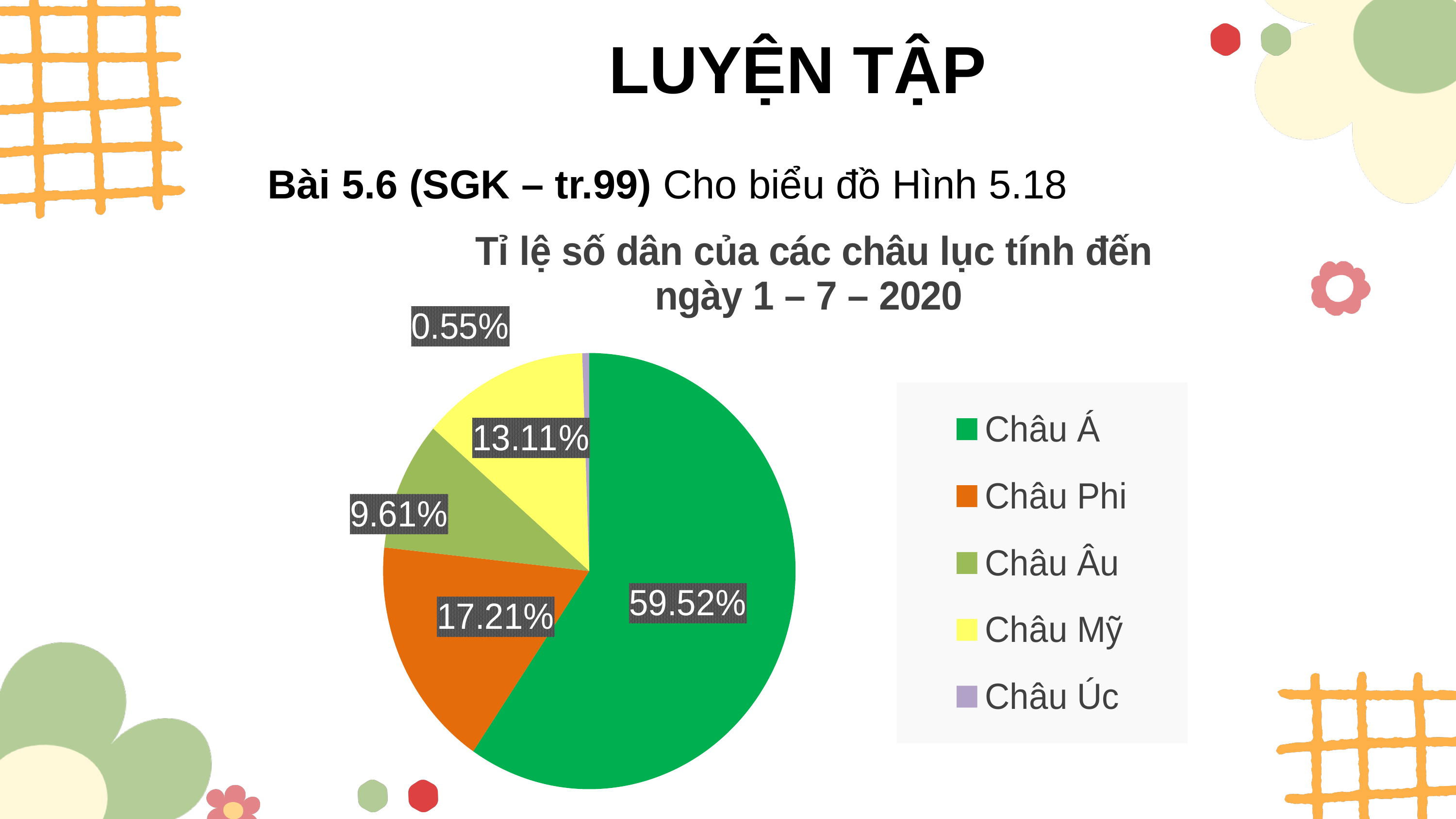
Which continent is represented by the yellow slice? Châu Mỹ Which continent has the largest share in the pie chart? Châu Á How many continents are shown in the pie chart? 5 What percentage of the population does Châu Á account for in the pie chart? 59.52% What is the value for Châu Úc in the pie chart? 0.55% What type of chart is shown on the slide? Pie chart What is the value shown for Châu Phi in the pie chart? 17.21% Which continent has the smallest share in the pie chart? Châu Úc What percentage is shown for Châu Mỹ? 13.11% Which has a larger share, Châu Mỹ or Châu Âu? Châu Mỹ What is the difference between the shares of Châu Phi and Châu Âu? 7.60% What is the title of the chart? Tỉ lệ số dân của các châu lục tính đến ngày 1 – 7 – 2020